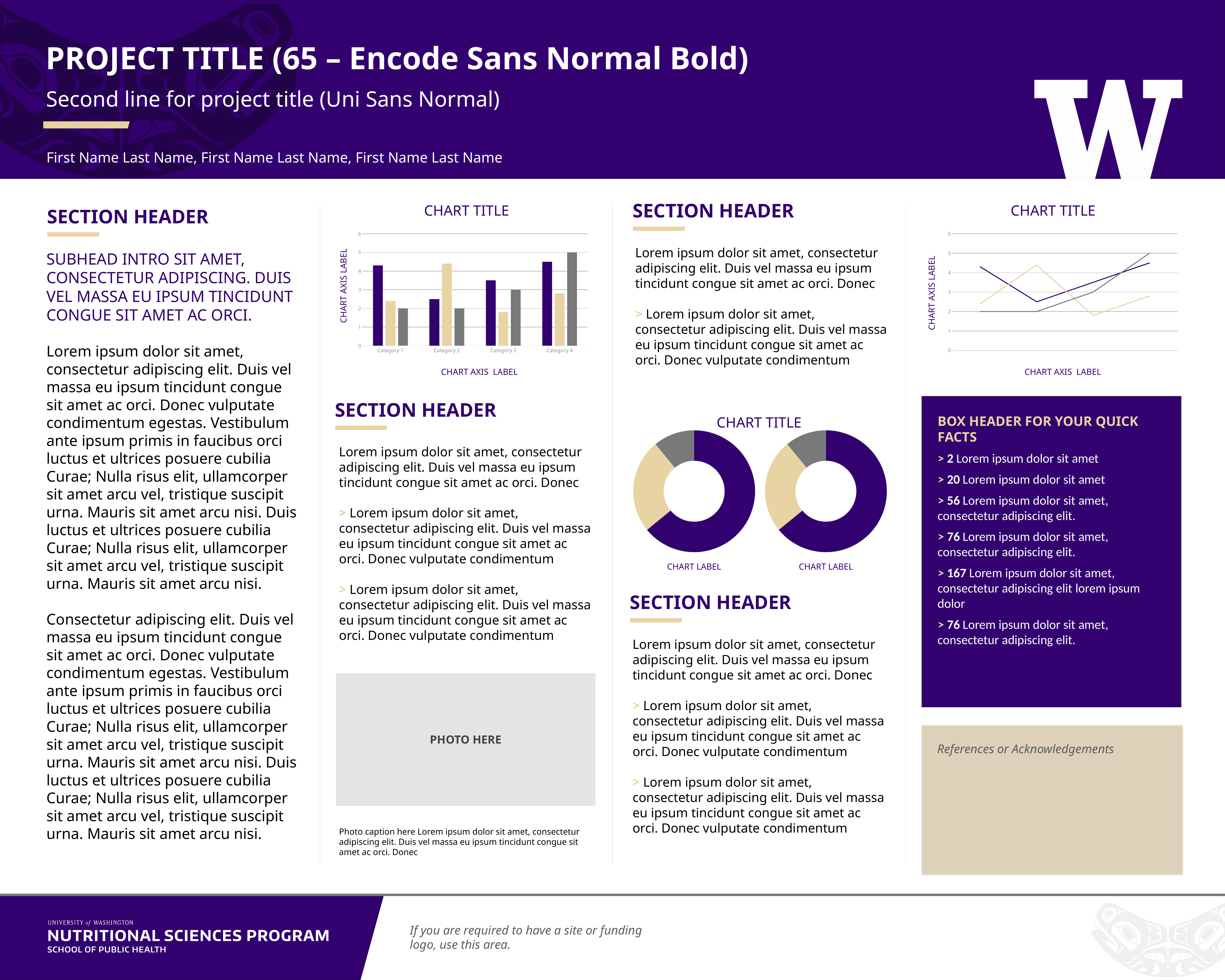
What kind of charts are the two circular charts in the middle of the third column? donut charts What kind of chart is shown at the top of the second column? bar chart How many categories does the bar chart at the top of the second column show? 4 In the bar chart at the top of the second column, which category has the tallest bar overall? Category 4 What kind of chart is shown at the top of the right-hand column? line chart In the bar chart at the top of the second column, is the tan bar for Category 3 greater or less than 2? less In the left donut chart in the third column, which colour takes up the largest share? purple In the bar chart at the top of the second column, is the purple bar for Category 1 greater or less than 4? greater In the bar chart at the top of the second column, is the purple bar for Category 2 greater or less than 3? less In the bar chart at the top of the second column, which is larger for Category 2: the purple bar or the tan bar? the tan bar In the line chart at the top of the right-hand column, does the gray line rise or fall from left to right? rise What is the title of the bar chart at the top of the second column? CHART TITLE